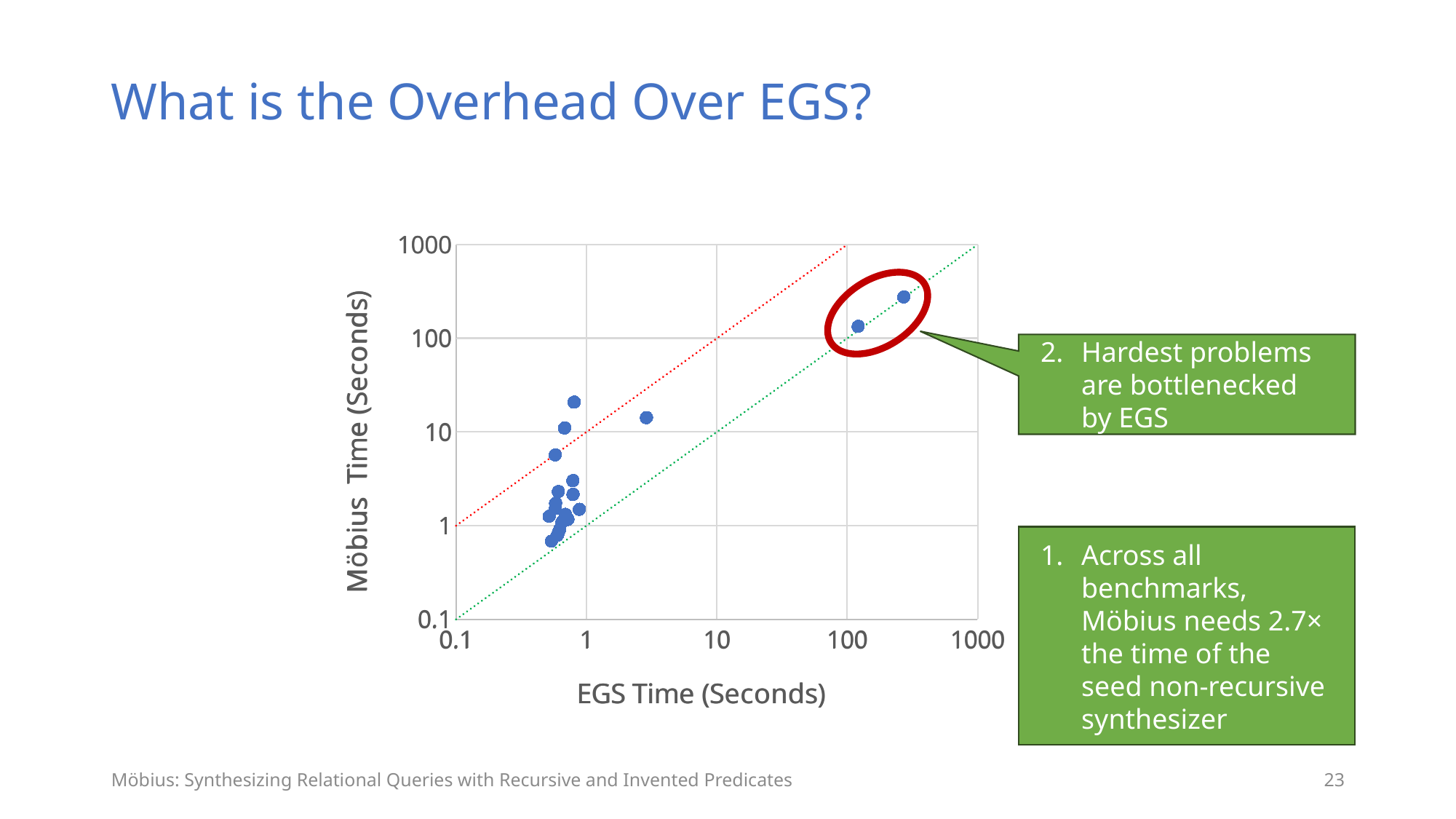
Is the Möbius time for the lowest plotted point greater or less than 1? less What is the label of the y axis? Möbius Time (Seconds) Is the Möbius time for the isolated point with EGS time between 1 and 10 greater or less than 10? greater Do the Möbius times generally rise or fall as EGS time increases along the x axis? rise Is the EGS time for the two circled points greater or less than 100? greater What is the label of the x axis? EGS Time (Seconds) What is the lowest tick value shown on the x axis? 0.1 What kind of chart is shown on the slide? Scatter chart What is the highest tick value shown on the y axis? 1000 Which point has the highest Möbius time: the one with EGS time above 100 or the one with EGS time between 1 and 10? The one with EGS time above 100